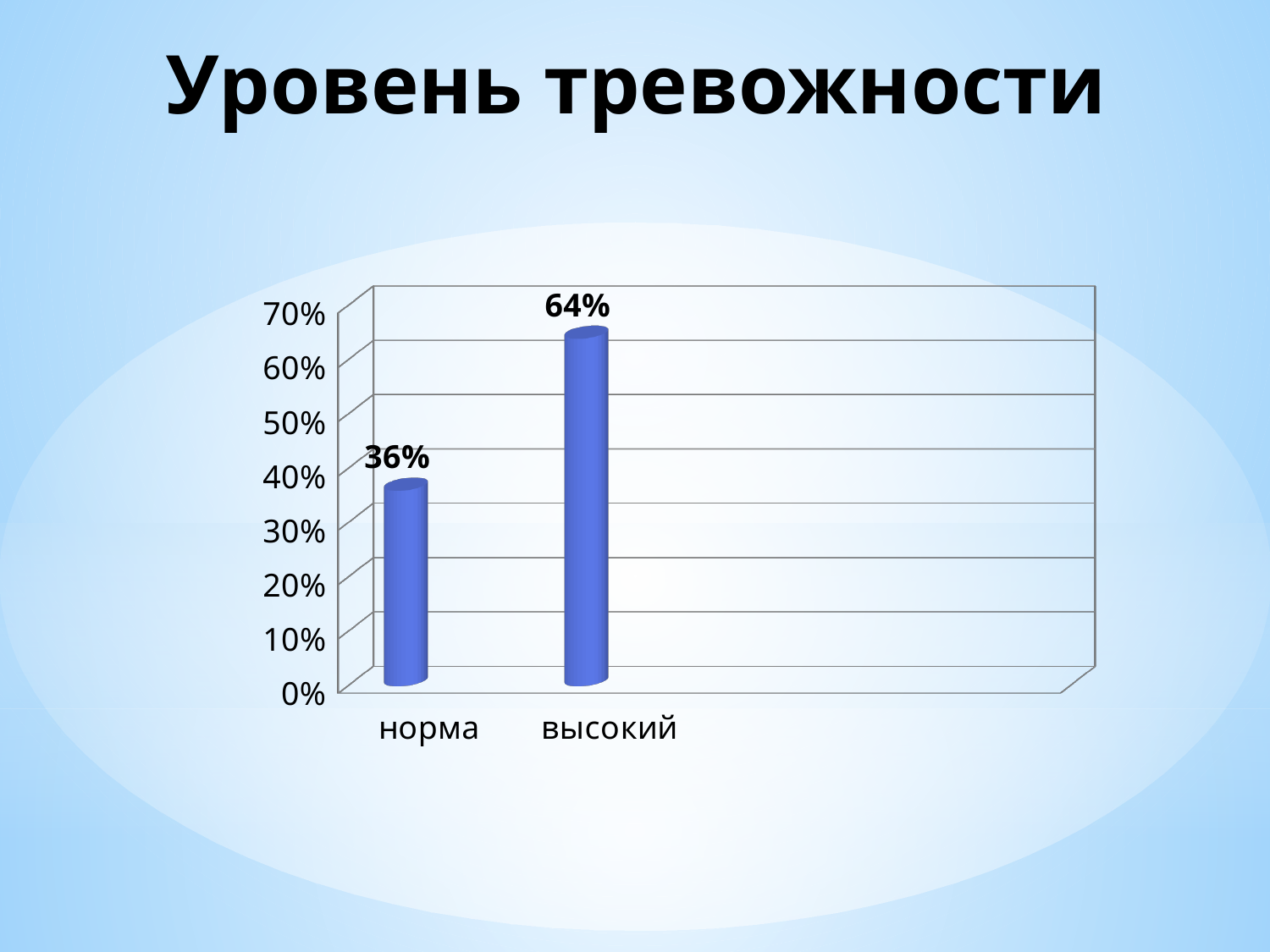
What is the title of the slide? Уровень тревожности What is the value for высокий? 64% Which category has the lowest value? норма Which category has the highest value? высокий Which is larger, the value for норма or the value for высокий? высокий Is the value for высокий greater or less than 60%? greater What is the difference between the values for высокий and норма? 28% What is the value for норма? 36% What kind of chart is shown on the slide? bar chart How many categories are shown on the chart? 2 What is the highest value shown on the vertical axis? 70% Is the value for норма greater or less than 40%? less